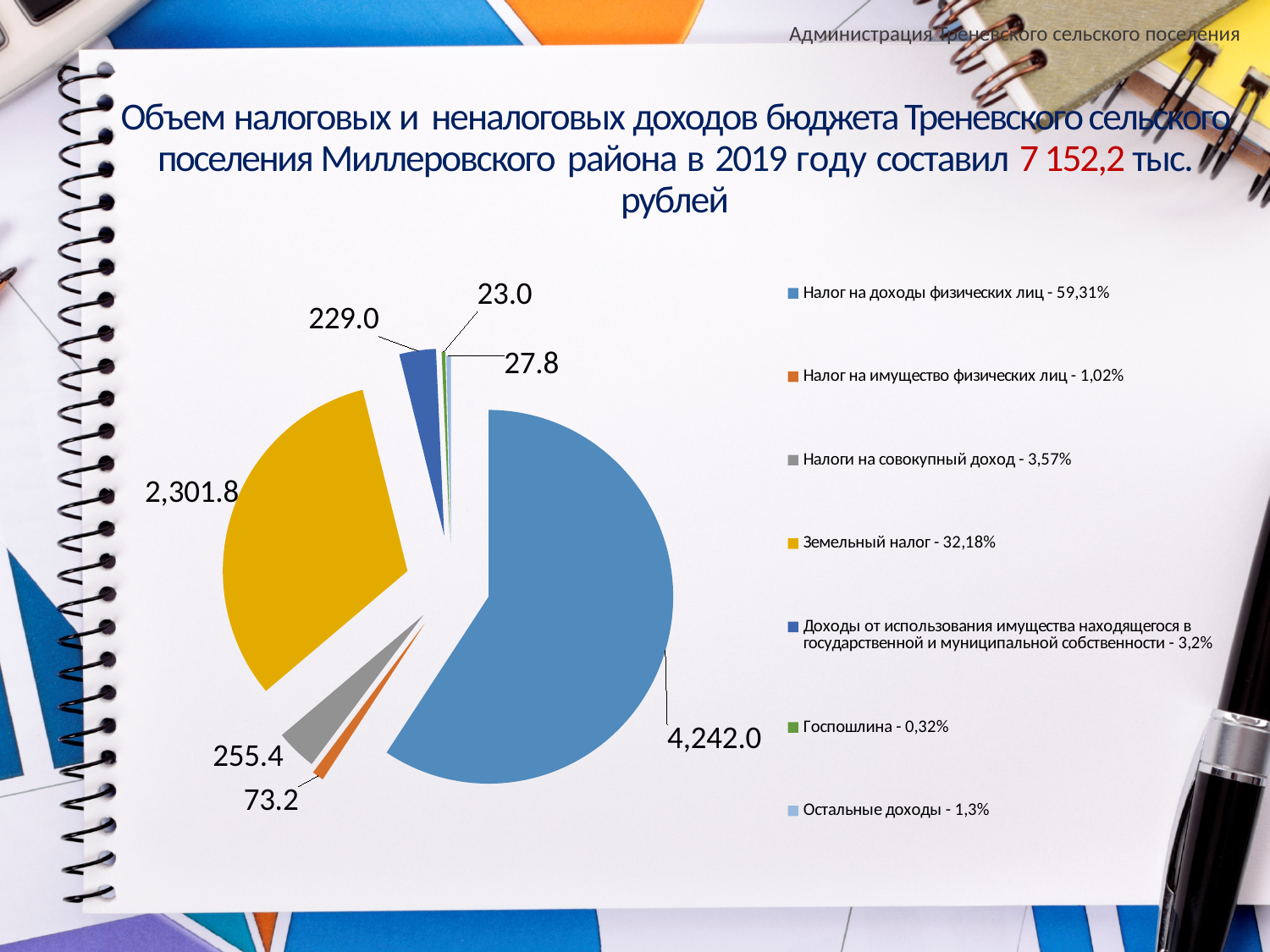
How many slices does the pie chart have? 7 What is the value shown for Налог на доходы физических лиц? 4,242.0 What type of chart is shown on the slide? pie chart Which category has the smallest slice of the pie? Госпошлина What is the value shown for Земельный налог? 2,301.8 What is the value shown for Госпошлина? 23.0 Which category has the largest slice of the pie? Налог на доходы физических лиц What is the difference between the values for Налог на доходы физических лиц and Земельный налог? 1,940.2 What colour is the slice for Налог на имущество физических лиц? orange According to the legend, what share of the pie does Земельный налог represent? 32,18% What is the value shown for Налоги на совокупный доход? 255.4 Which is larger: the value for Налоги на совокупный доход or the value for Доходы от использования имущества находящегося в государственной и муниципальной собственности? Налоги на совокупный доход